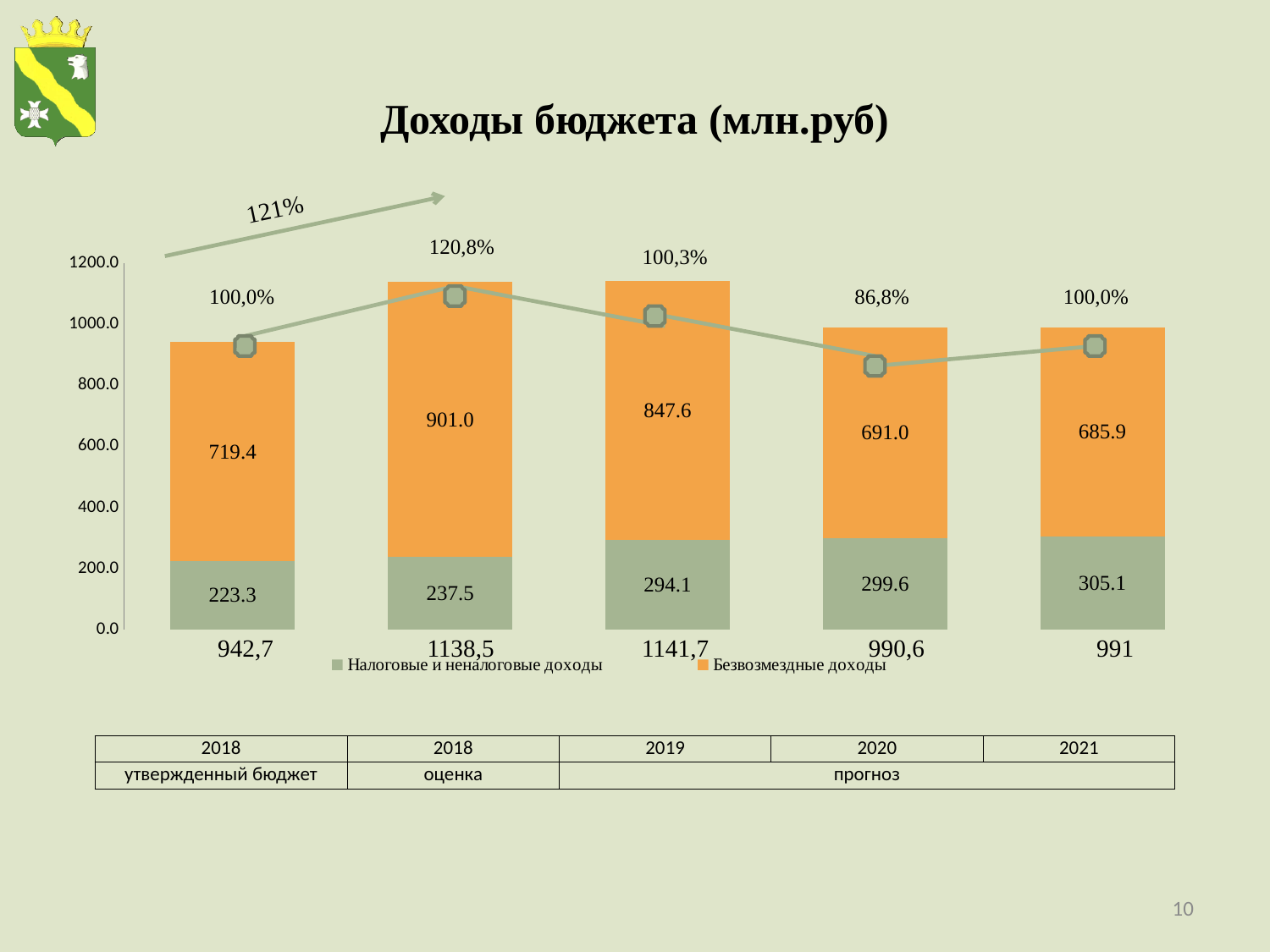
What is the value of Налоговые и неналоговые доходы in the third bar (labelled 1141,7)? 294.1 How many series does the chart legend list? 2 What percentage is shown above the fourth bar (labelled 990,6)? 86,8% What kind of chart is shown on the slide? stacked bar chart with a line How many bars are plotted in the chart? 5 Which bar has the lowest value of Налоговые и неналоговые доходы? the first bar (942,7) What is the value of Безвозмездные доходы in the first bar (labelled 942,7)? 719.4 What is the difference between Безвозмездные доходы in the second bar (901.0) and in the fourth bar (691.0)? 210.0 What is the value of Безвозмездные доходы in the last bar (labelled 991)? 685.9 Is the value of Налоговые и неналоговые доходы larger in the fourth bar (990,6) or in the fifth bar (991)? the fifth bar (991) What is the title of the chart? Доходы бюджета (млн.руб) Which bar has the highest value of Безвозмездные доходы? the second bar (1138,5)